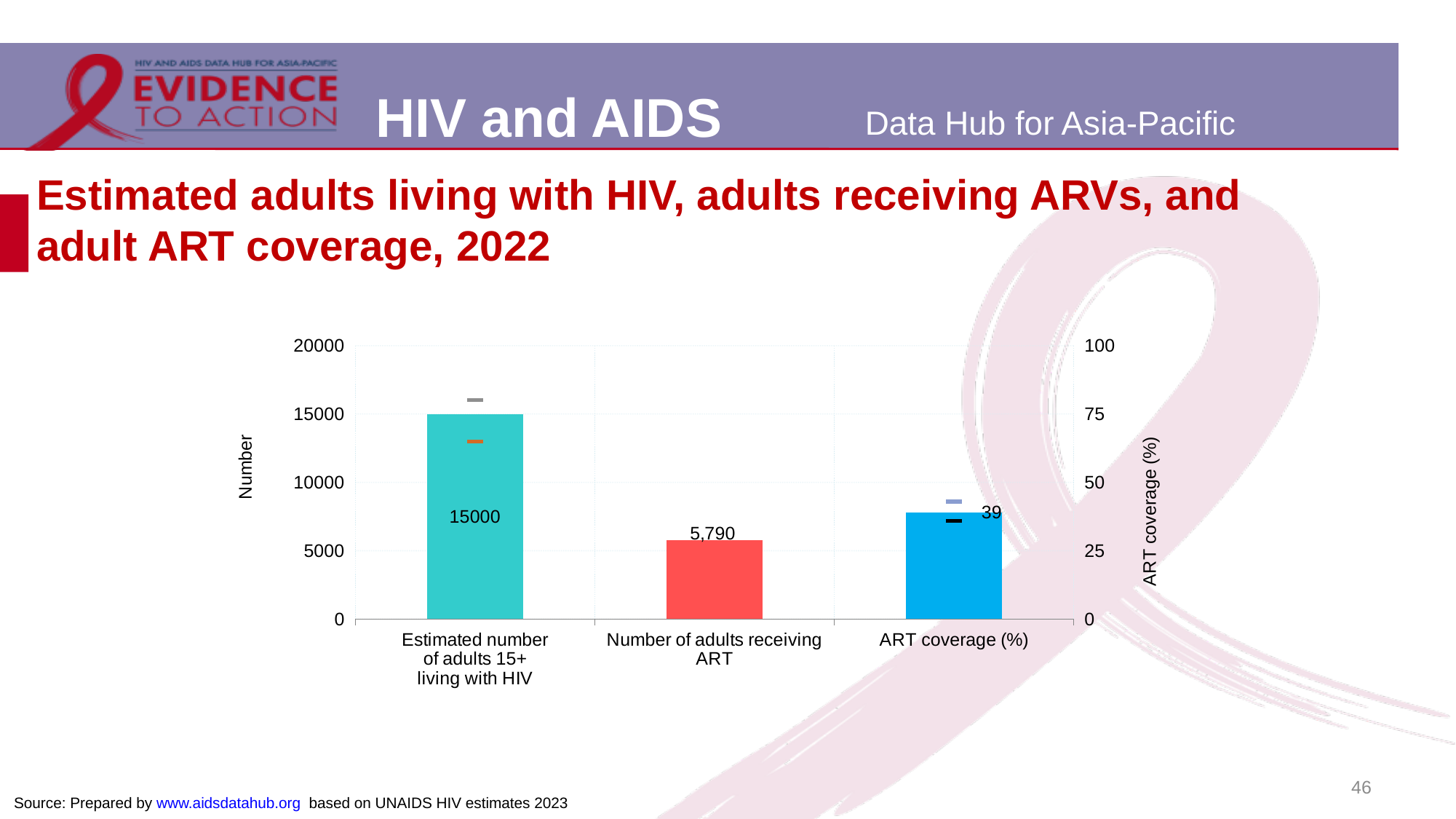
What is the estimated number of adults 15+ living with HIV shown on the chart? 15000 Which category has the tallest bar on the chart? Estimated number of adults 15+ living with HIV What is the number of adults receiving ART shown on the chart? 5,790 Is the ART coverage (%) value greater or less than 50 on the right-hand axis? less What is the ART coverage (%) value shown on the chart? 39 What is the title of the right-hand vertical axis of the chart? ART coverage (%) Which category has the shortest bar on the chart? Number of adults receiving ART Which is larger: the estimated number of adults 15+ living with HIV or the number of adults receiving ART? Estimated number of adults 15+ living with HIV How many categories are shown on the x axis of the chart? 3 What kind of chart is shown on the slide? Bar chart Is the number of adults receiving ART greater or less than 5000? greater What is the difference between the estimated number of adults 15+ living with HIV and the number of adults receiving ART? 9,210